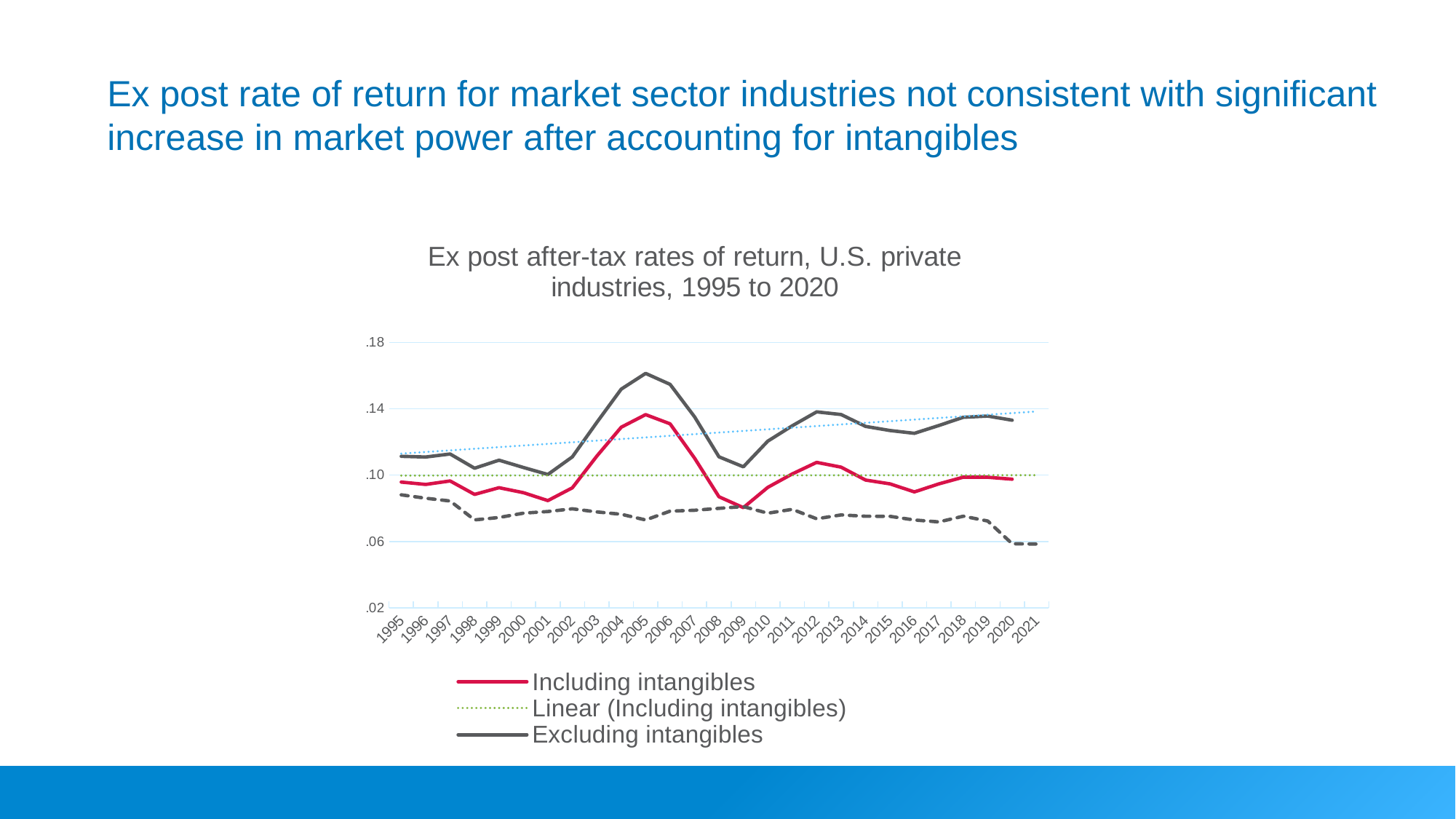
In 2005, which series has the larger value, Including intangibles or Excluding intangibles? Excluding intangibles Does the Excluding intangibles series rise or fall from 2001 to 2005? Rise What is the title of the chart? Ex post after-tax rates of return, U.S. private industries, 1995 to 2020 Is the value for Including intangibles in 2009 greater or less than .10? less How many series does the legend list? 3 What kind of chart is shown on the slide? Line chart In which year does the Including intangibles series reach its lowest value? 2009 Which series is drawn in red? Including intangibles Is the value for Excluding intangibles in 2005 greater or less than .14? greater In which year does the Excluding intangibles series reach its highest value? 2005 In which year does the Including intangibles series reach its highest value? 2005 Is the value for Including intangibles in 2001 greater or less than .10? less